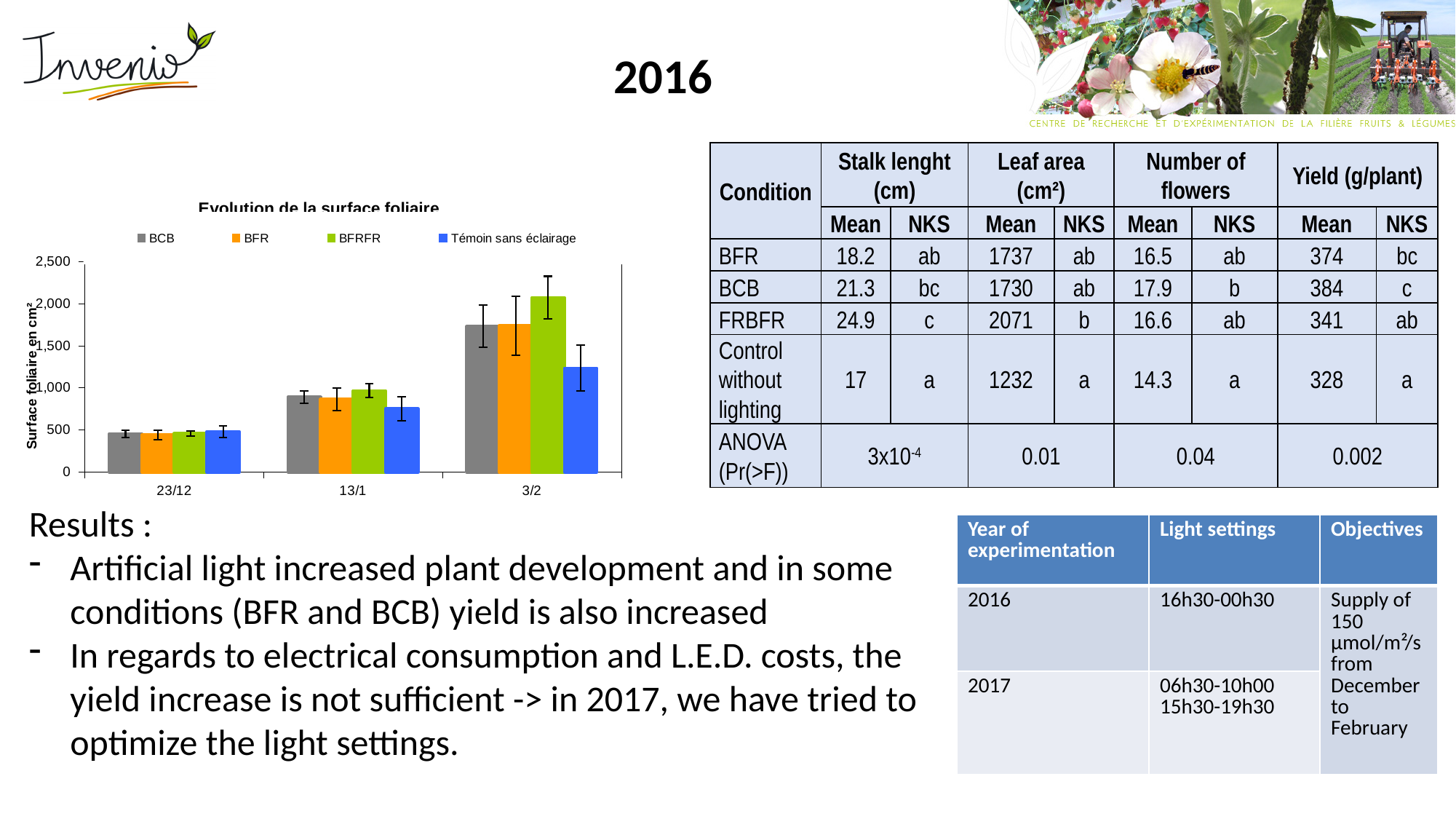
Is the value for Témoin sans éclairage at 13/1 greater or less than 500? greater Is the value for BCB at 13/1 greater or less than 1,000? less Which series has the highest value at 3/2? BFRFR At 13/1, which is larger: BFRFR or Témoin sans éclairage? BFRFR What colour represents Témoin sans éclairage in the chart? blue How many dates are shown on the x axis of the chart? 3 How many series does the chart legend list? 4 Is the value for Témoin sans éclairage at 3/2 greater or less than 1,000? greater What is the title of the chart? Evolution de la surface foliaire Which series has the lowest value at 3/2? Témoin sans éclairage Do the values for BCB rise or fall from 23/12 to 3/2? rise What kind of chart is shown on the slide? bar chart